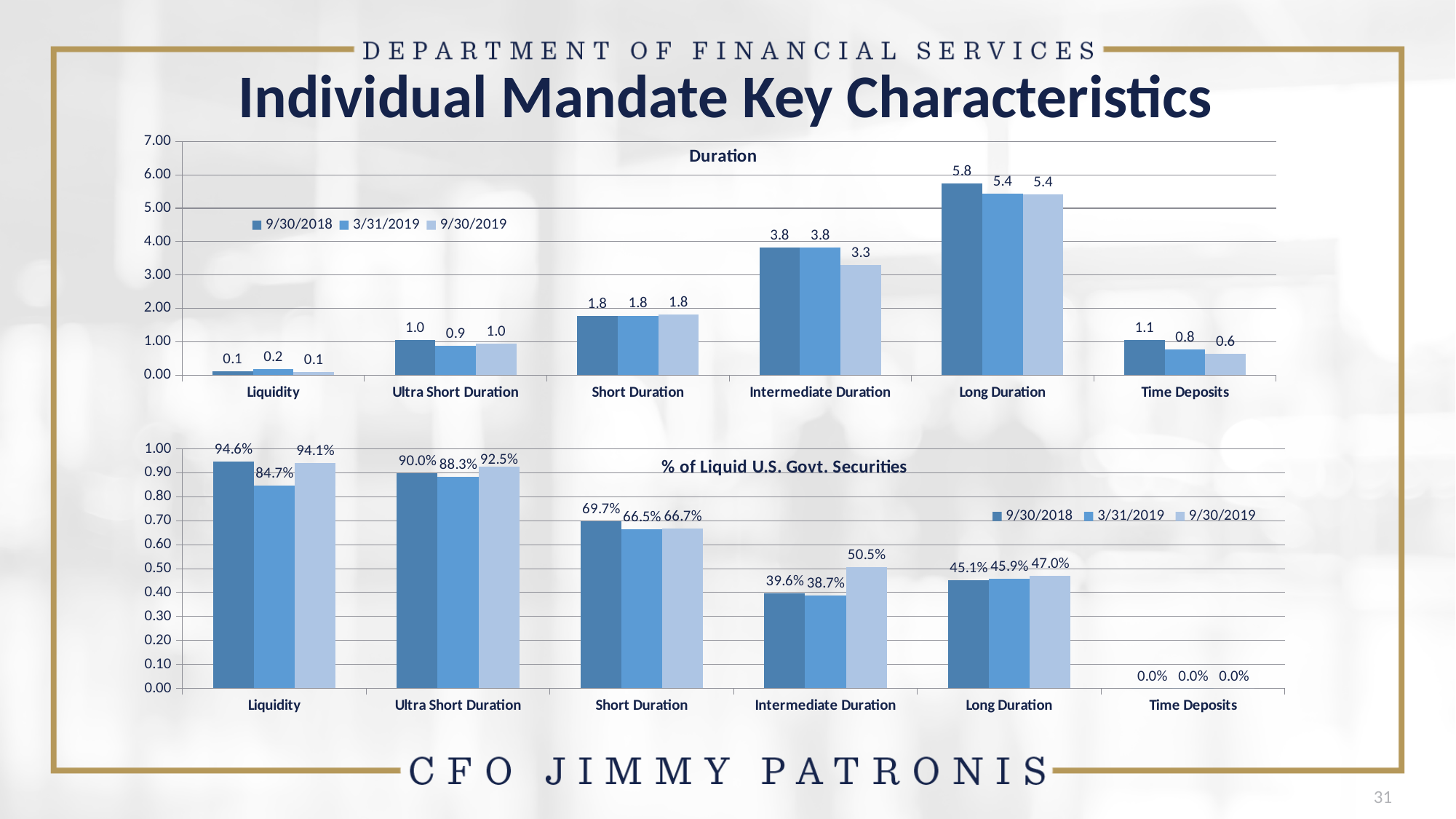
In the Duration chart, what is the value for Intermediate Duration on 9/30/2019? 3.3 In the % of Liquid U.S. Govt. Securities chart, what is the value for Intermediate Duration on 9/30/2019? 50.5% In the Duration chart, which category has the highest value for 9/30/2019? Long Duration In the % of Liquid U.S. Govt. Securities chart, which is larger for Short Duration: the 9/30/2018 value or the 3/31/2019 value? 9/30/2018 In the Duration chart, what is the value for Long Duration on 9/30/2018? 5.8 In the % of Liquid U.S. Govt. Securities chart, which category has the lowest values? Time Deposits In the Duration chart, how many series does the legend list? 3 In the Duration chart, how many categories are shown on the x axis? 6 In the % of Liquid U.S. Govt. Securities chart, what is the value for Liquidity on 3/31/2019? 84.7% In the % of Liquid U.S. Govt. Securities chart, what is the difference between the 9/30/2019 and 3/31/2019 values for Ultra Short Duration? 4.2% What type of chart is the Duration chart? Bar chart In the Duration chart, what is the difference between the 9/30/2018 and 9/30/2019 values for Time Deposits? 0.5